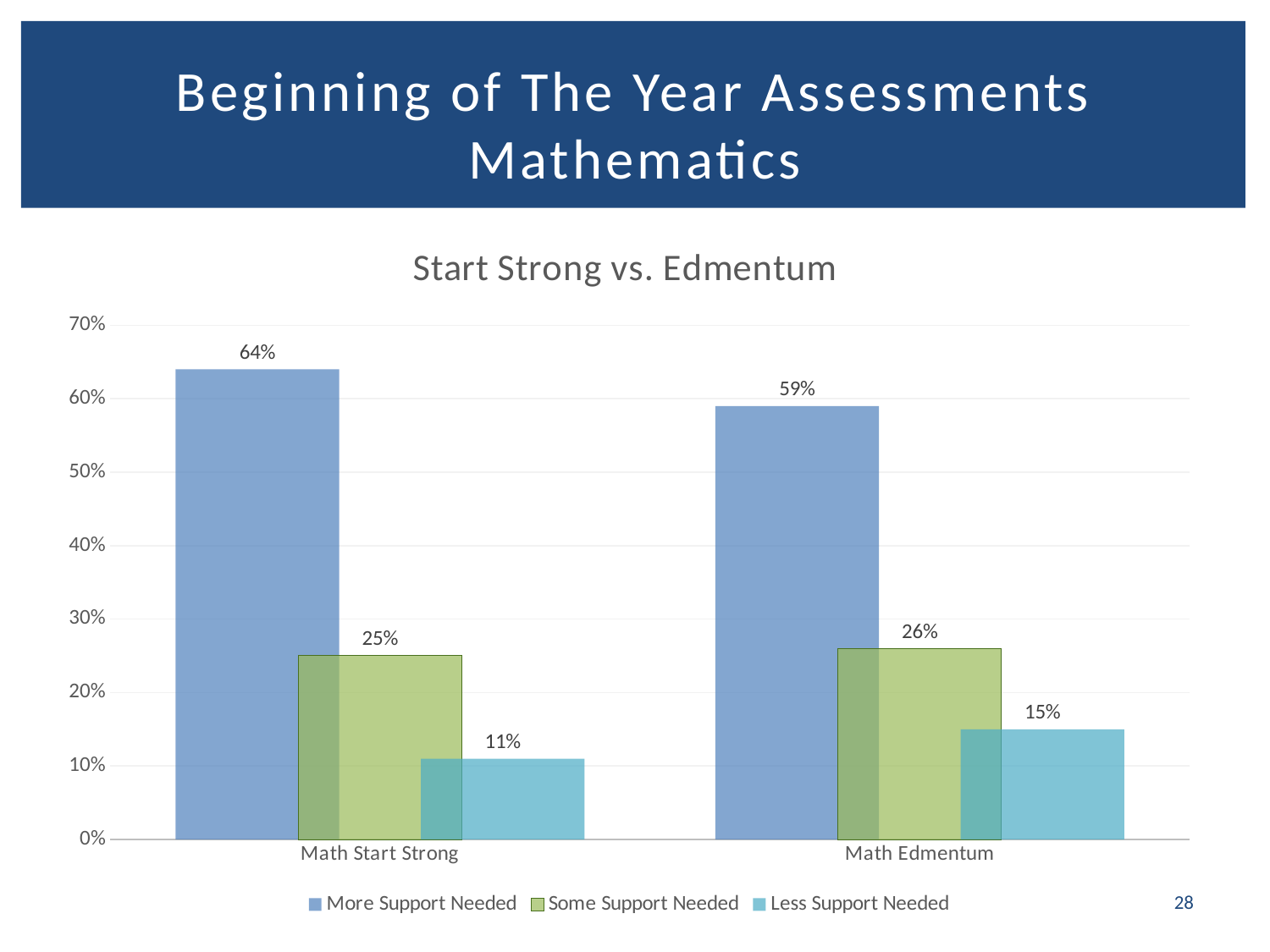
Is the value for More Support Needed in Math Edmentum greater or less than 50%? greater Which is larger: Less Support Needed in Math Start Strong or in Math Edmentum? Math Edmentum What kind of chart is shown? bar chart What is the value for Less Support Needed in Math Edmentum? 15% What is the value for More Support Needed in Math Start Strong? 64% What is the title of the chart? Start Strong vs. Edmentum Which series has the lowest value in Math Start Strong? Less Support Needed How many series does the legend list? 3 What is the difference between More Support Needed in Math Start Strong and in Math Edmentum? 5% How many categories are shown on the x axis? 2 Which series has the highest value in Math Edmentum? More Support Needed What is the value for Some Support Needed in Math Start Strong? 25%